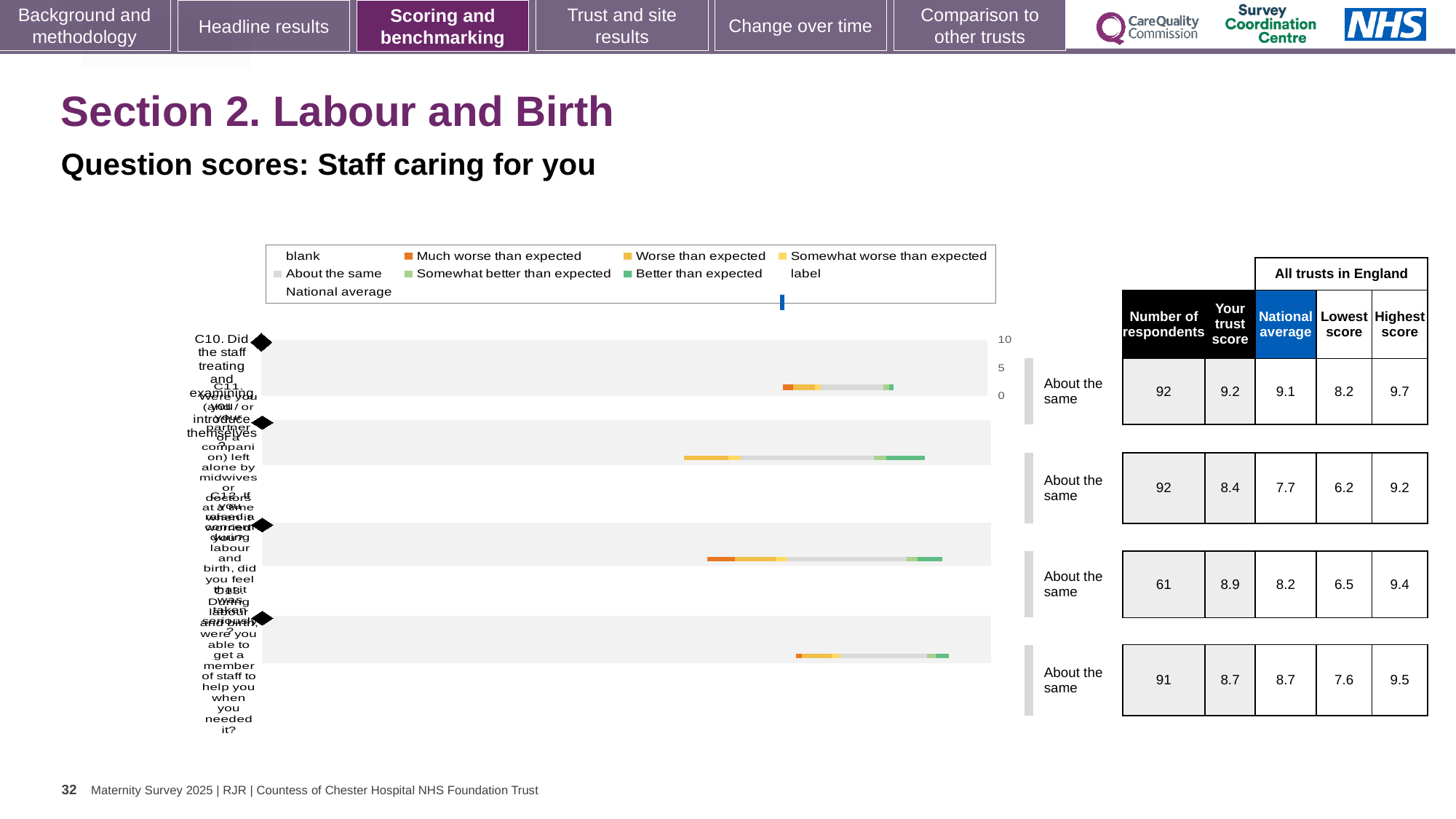
Which row has the lowest 'Your trust score'? C11 (second row), 8.4 What is the national average for question C11 (the second row)? 7.7 For question C12 (the third row), which is larger: the trust score or the national average? the trust score (8.9) How many respondents answered question C12 (the third row)? 61 What is the highest score among all trusts in England for question C13 (the fourth row)? 9.5 What is the maximum value shown on the chart's score axis? 10 For question C11 (the second row), what is the difference between the trust score and the national average? 0.7 How many questions (rows) are plotted in the chart? 4 What kind of chart is shown on the slide? bar chart What is the 'Your trust score' for question C10 (the first row)? 9.2 Which row has the highest 'Your trust score'? C10 (first row), 9.2 What benchmark category is shown for every row in the chart? About the same